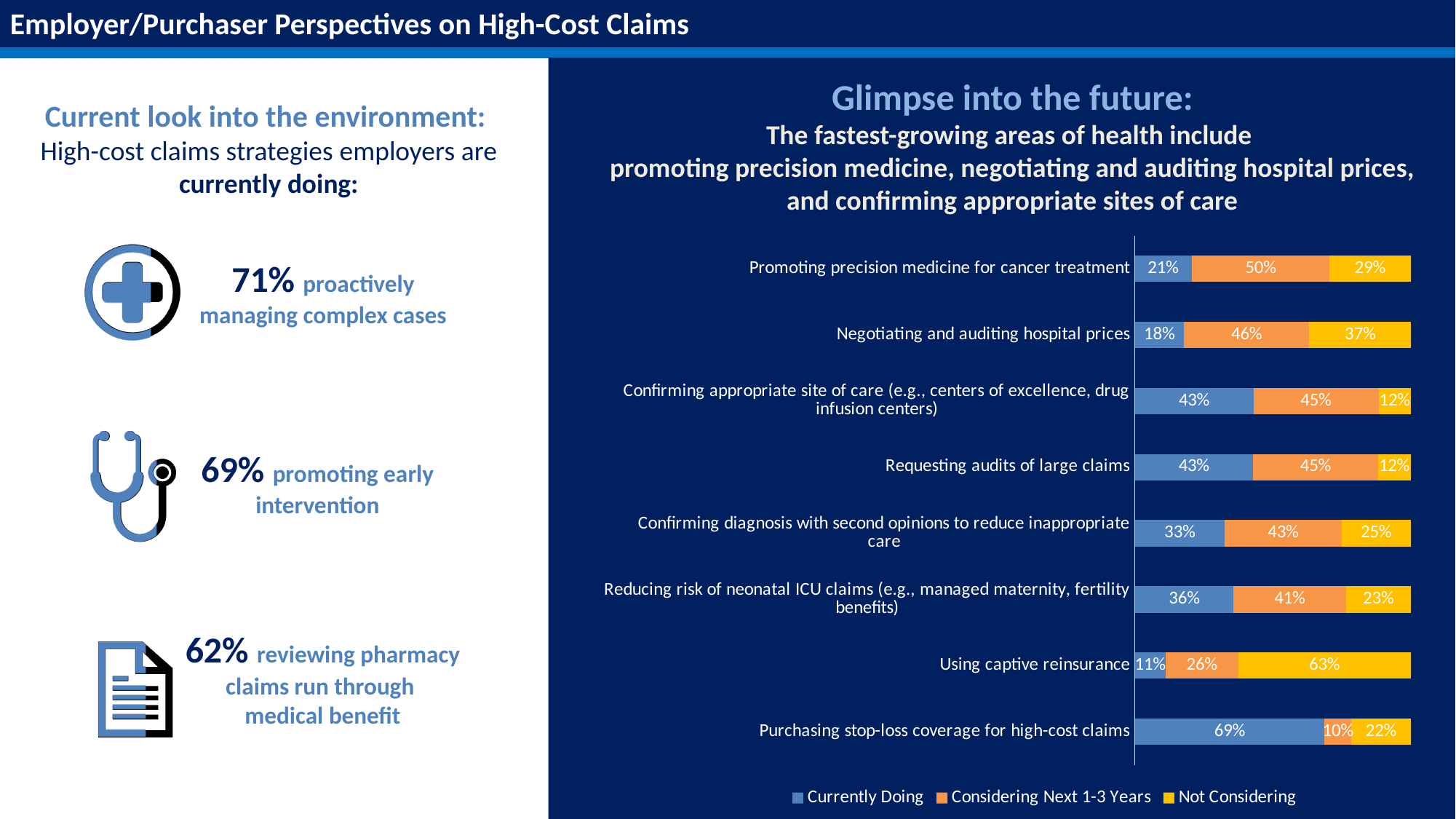
How many series does the legend list? 3 What percentage are 'Considering Next 1-3 Years' for 'Negotiating and auditing hospital prices'? 46% What percentage of employers are currently doing 'Promoting precision medicine for cancer treatment'? 21% What percentage are 'Not Considering' 'Using captive reinsurance'? 63% What is the difference between the 'Not Considering' percentages for 'Negotiating and auditing hospital prices' and 'Promoting precision medicine for cancer treatment'? 8% How many categories are shown in the bar chart? 8 Which category has the highest 'Currently Doing' percentage? Purchasing stop-loss coverage for high-cost claims What is the total of the stacked bar for 'Reducing risk of neonatal ICU claims (e.g., managed maternity, fertility benefits)'? 100% What kind of chart is shown on the right side of the slide? Stacked bar chart Which is larger: the 'Currently Doing' value for 'Requesting audits of large claims' or for 'Confirming diagnosis with second opinions to reduce inappropriate care'? Requesting audits of large claims Which category has the lowest 'Currently Doing' percentage? Using captive reinsurance Which series is shown in orange in the legend? Considering Next 1-3 Years